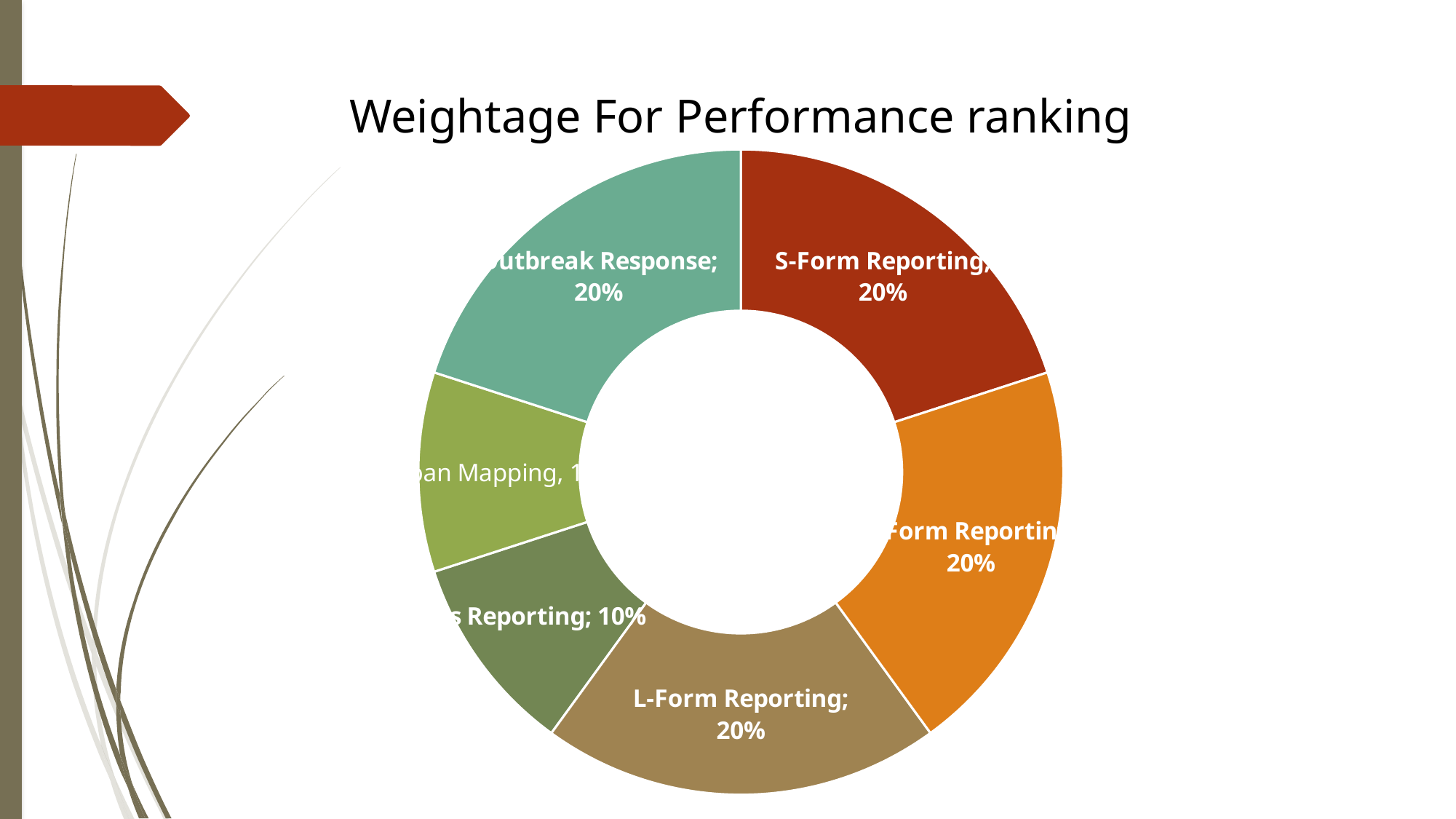
What is the weightage for Outbreak Response? 20% What is the weightage for S-Form Reporting? 20% What kind of chart is shown on the slide? Doughnut (pie) chart What is the weightage for L-Form Reporting? 20% What is the title of the chart? Weightage For Performance ranking How many slices does the chart have? 6 What is the difference between the weightage for S-Form Reporting and the weightage for Outbreak Response? 0% What is the combined weightage of S-Form Reporting, L-Form Reporting and Outbreak Response? 60% What colour is the S-Form Reporting slice? Dark red